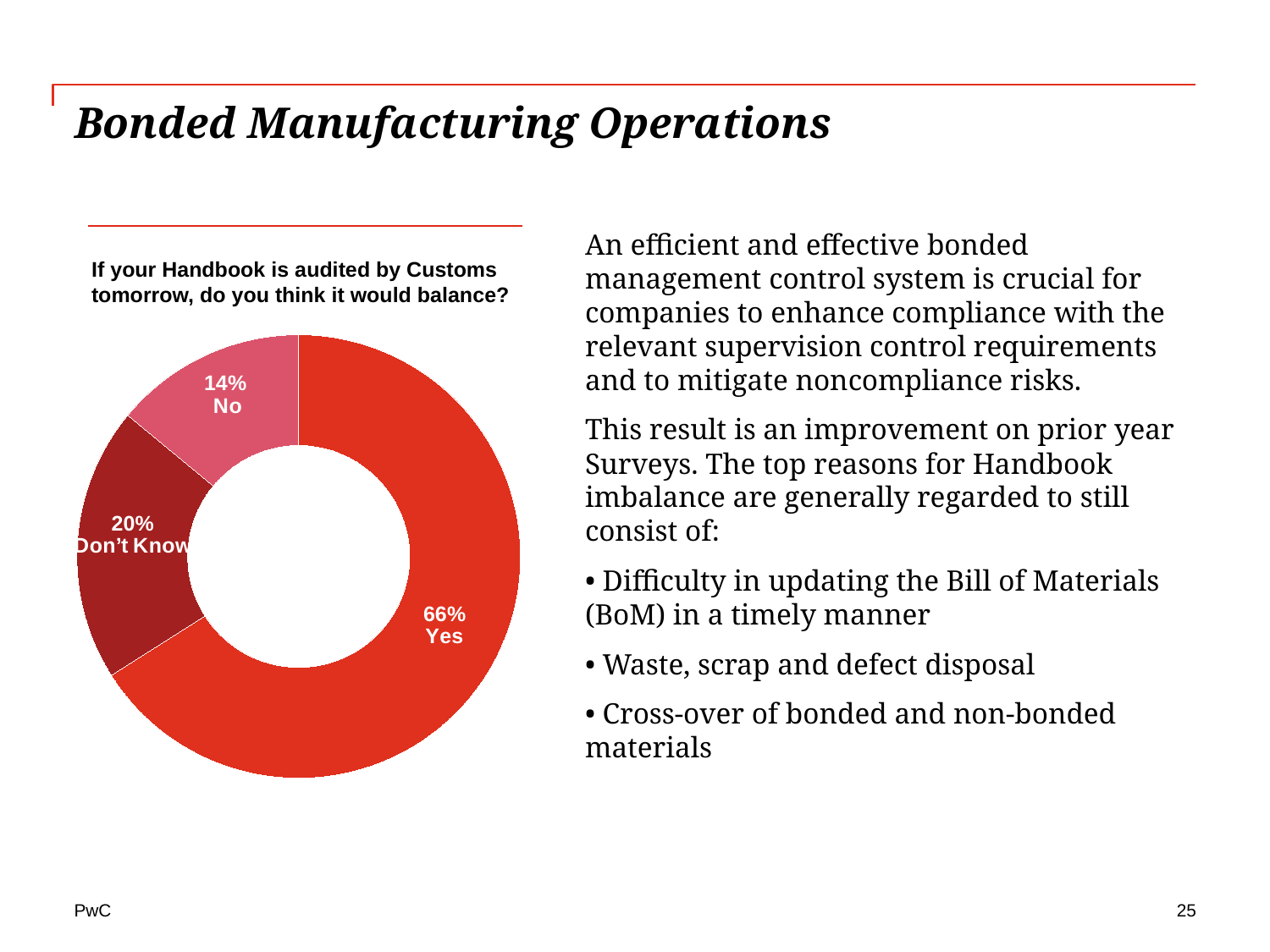
Which response has the largest share of the chart? Yes What is the title of the chart? If your Handbook is audited by Customs tomorrow, do you think it would balance? What is the combined share of the "No" and "Don't Know" responses? 34% Which response has the smallest share of the chart? No How many response categories are shown in the chart? 3 What kind of chart is shown on the slide? Doughnut (pie) chart What is the difference in percentage points between the "Yes" and "Don't Know" shares? 46 What is the difference in percentage points between the "Don't Know" and "No" shares? 6 What share of respondents answered "Yes"? 66% What share of respondents answered "Don't Know"? 20% Which is larger, the share for "Don't Know" or the share for "No"? Don't Know What share of respondents answered "No"? 14%